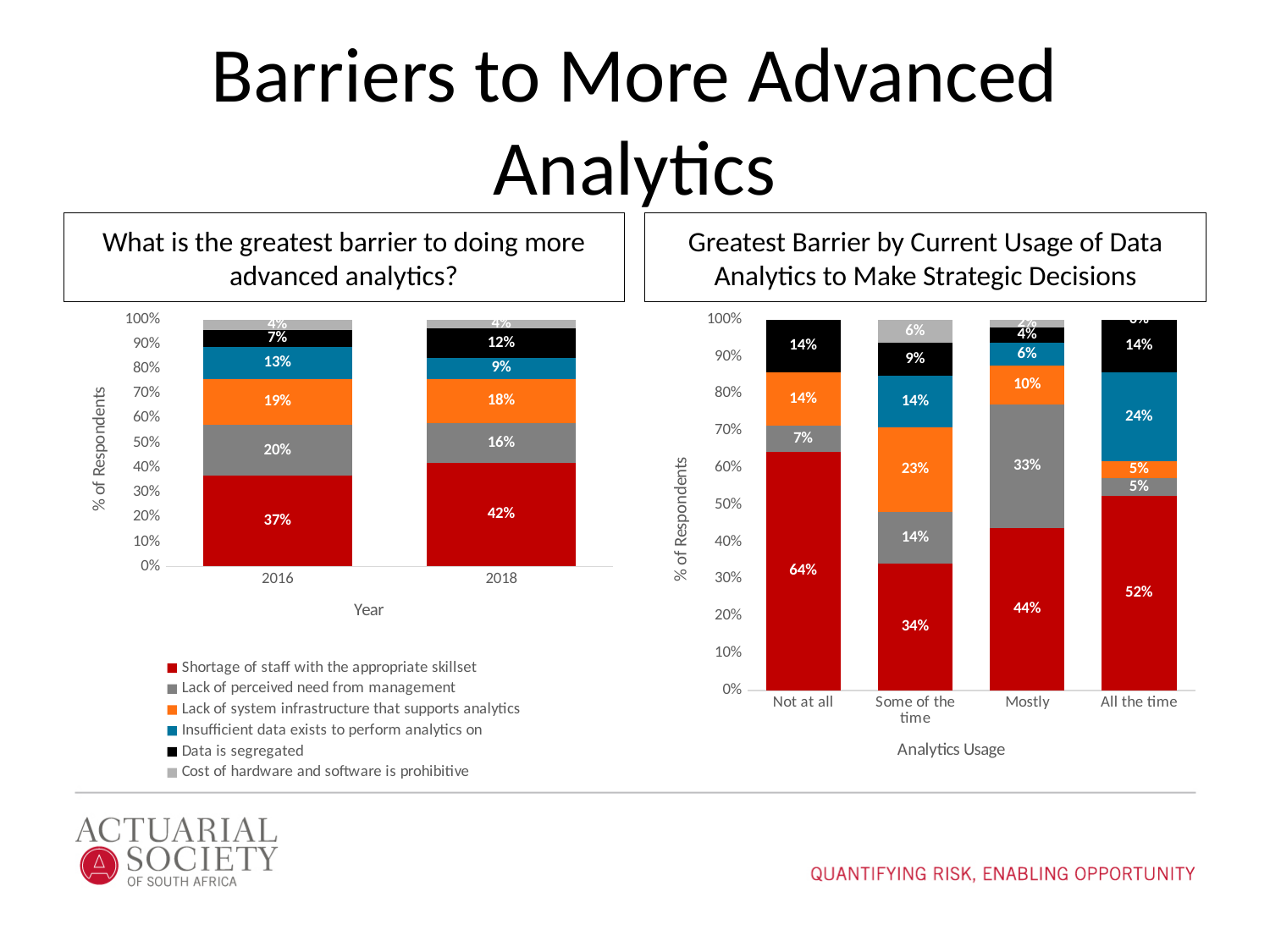
In the left chart, did the data is segregated segment rise or fall from 2016 to 2018? rise In the right chart, which analytics usage group has the highest share for shortage of staff with the appropriate skillset? Not at all In the right chart, which analytics usage group has the lowest share for shortage of staff with the appropriate skillset? Some of the time In the left chart, by how many percentage points did the shortage of staff with the appropriate skillset segment change from 2016 to 2018? 5 percentage points In the left chart, which is larger in 2018: insufficient data exists to perform analytics on or data is segregated? Data is segregated What type of chart is the right chart? Stacked bar chart In the left chart, what was the value for lack of perceived need from management in 2016? 20% In the right chart (Greatest Barrier by Current Usage of Data Analytics to Make Strategic Decisions), what percentage of respondents who use analytics not at all cited shortage of staff with the appropriate skillset? 64% How many series does the legend on the slide list? 6 How many analytics usage categories are shown on the x axis of the right chart? 4 In the left chart (What is the greatest barrier to doing more advanced analytics?), what percentage of respondents in 2018 cited shortage of staff with the appropriate skillset? 42%